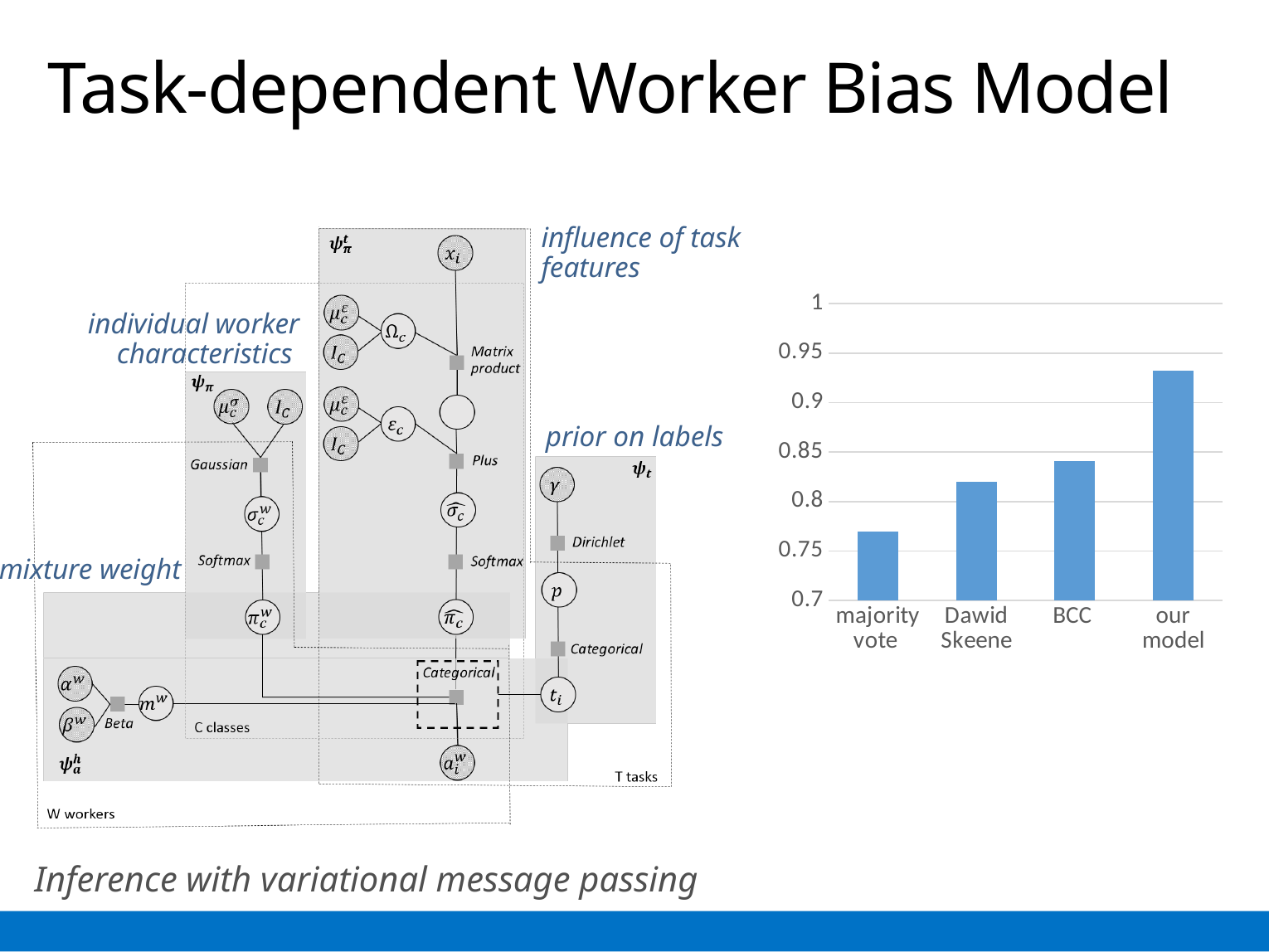
Do the bar values rise or fall from left to right across the categories? rise Which is larger, the value for majority vote or the value for Dawid Skeene? Dawid Skeene Which category has the highest bar in the chart? our model Which category has the lowest bar in the chart? majority vote Is the value for our model greater or less than 0.95? less Which is larger, the value for our model or the value for BCC? our model Is the value for majority vote greater or less than 0.8? less How many categories are plotted in the bar chart? 4 Is the value for our model greater or less than 0.9? greater What kind of chart is shown on the right side of the slide? bar chart